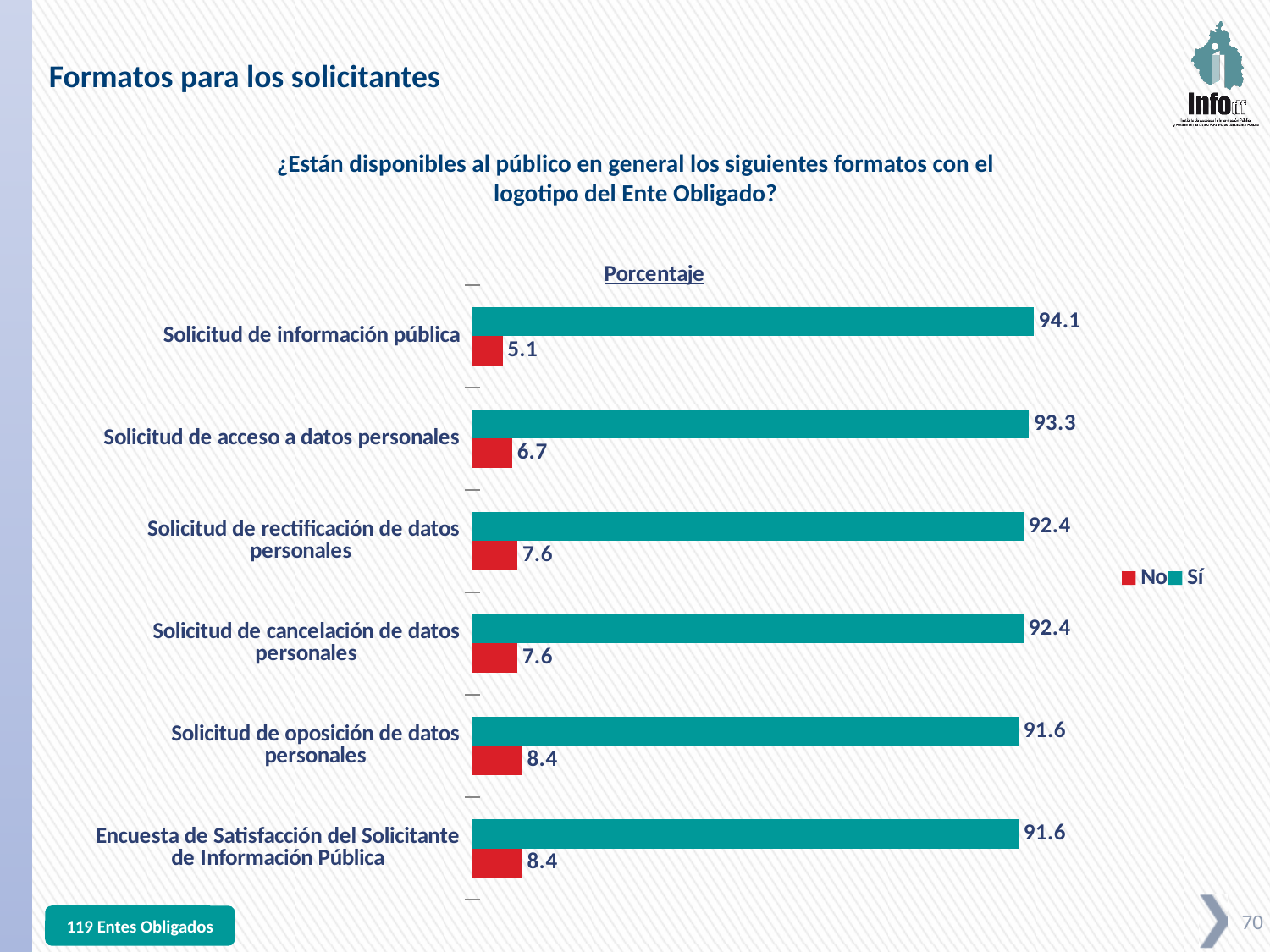
How many categories are shown in the chart? 6 What is the 'Sí' value for 'Solicitud de información pública'? 94.1 Which category has the lowest 'No' value? Solicitud de información pública What is the difference between the 'Sí' values for 'Solicitud de información pública' and 'Solicitud de oposición de datos personales'? 2.5 What is the 'Sí' value for 'Encuesta de Satisfacción del Solicitante de Información Pública'? 91.6 Which category has the highest 'Sí' value? Solicitud de información pública What is the total of the 'Sí' and 'No' values for 'Solicitud de cancelación de datos personales'? 100 How many series does the legend list? 2 What is the 'No' value for 'Solicitud de acceso a datos personales'? 6.7 What kind of chart is shown on the slide? Bar chart Which is larger: the 'No' value for 'Solicitud de rectificación de datos personales' or the 'No' value for 'Solicitud de oposición de datos personales'? Solicitud de oposición de datos personales Which colour represents the 'No' series in the chart? Red